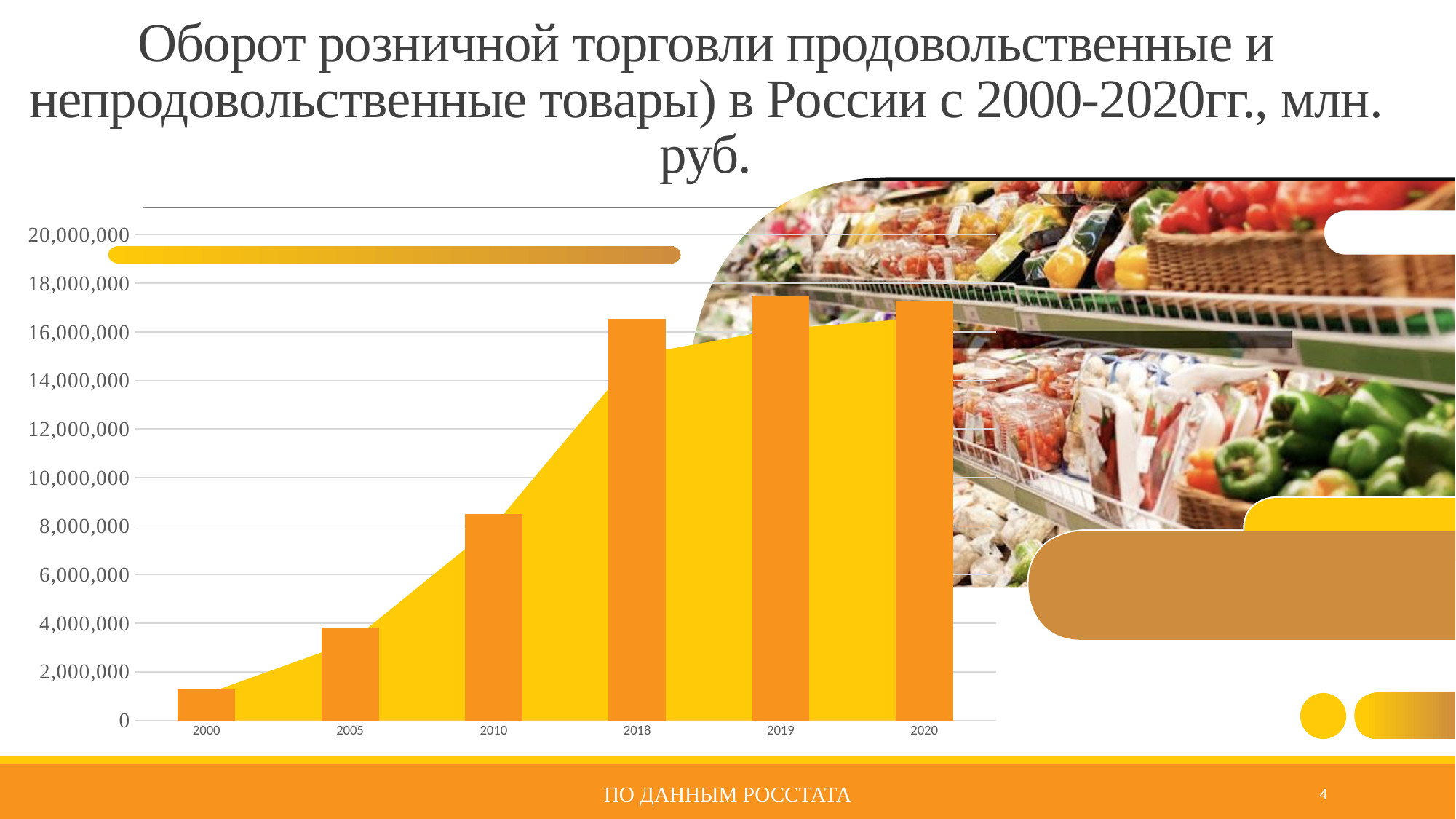
Is the value for 2000 greater or less than 2,000,000? less Which year has the lowest value in the chart? 2000 What is the data source stated at the bottom of the slide? ПО ДАННЫМ РОССТАТА Do the values generally rise or fall from 2000 to 2018? rise Is the value for 2010 greater or less than 8,000,000? greater Is the value for 2020 greater or less than 16,000,000? greater What kind of chart is shown on the slide? Combination area and bar chart How many years are shown on the x axis of the chart? 6 Which year has the larger value, 2010 or 2018? 2018 Which year has the larger value, 2005 or 2010? 2010